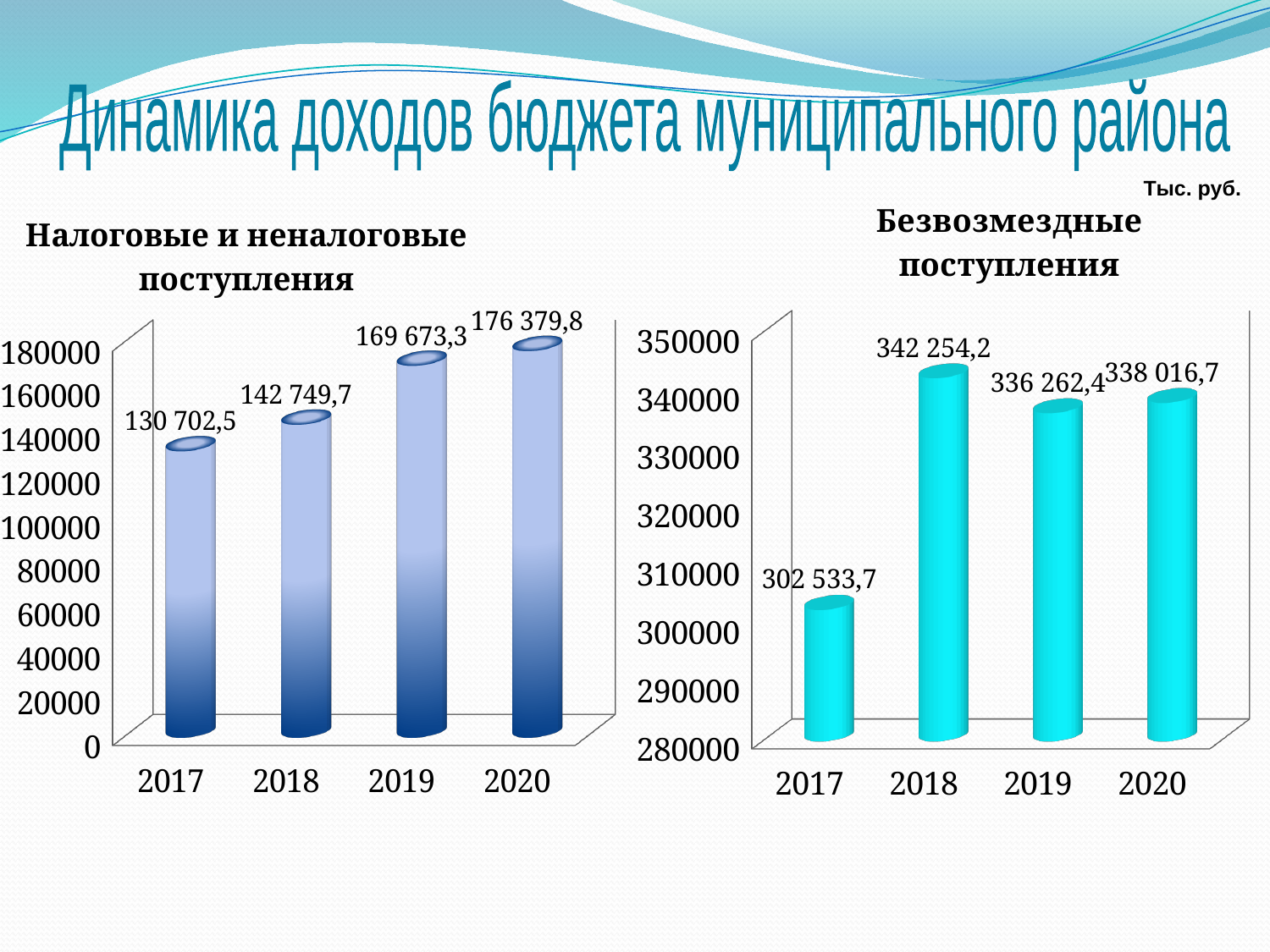
In the chart titled 'Налоговые и неналоговые поступления', what is the value for 2017? 130 702,5 In the chart titled 'Налоговые и неналоговые поступления', which year has the highest value? 2020 In the chart titled 'Безвозмездные поступления', what is the value for 2018? 342 254,2 How many years are shown on the x axis of the chart titled 'Налоговые и неналоговые поступления'? 4 In the chart titled 'Безвозмездные поступления', which is larger, the value for 2019 or the value for 2020? 2020 In the chart titled 'Безвозмездные поступления', which year has the lowest value? 2017 In the chart titled 'Безвозмездные поступления', which year has the highest value? 2018 Do the values in the chart titled 'Налоговые и неналоговые поступления' rise or fall from 2017 to 2020? rise In the chart titled 'Налоговые и неналоговые поступления', what is the difference between the 2020 and 2019 values? 6 706,5 In the chart titled 'Налоговые и неналоговые поступления', what is the value for 2019? 169 673,3 In the chart titled 'Безвозмездные поступления', what is the value for 2020? 338 016,7 In the chart titled 'Безвозмездные поступления', what is the difference between the 2018 and 2017 values? 39 720,5